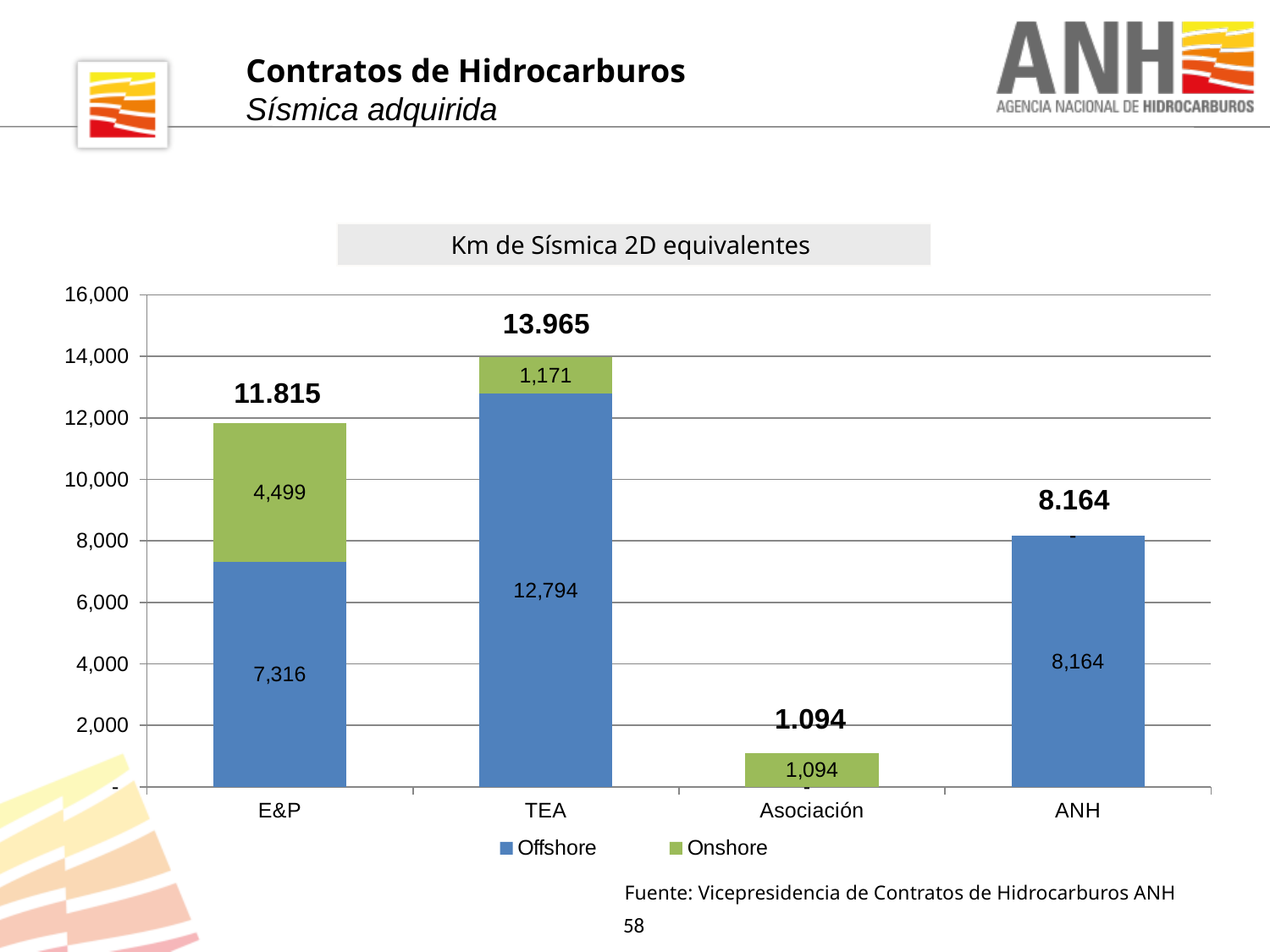
What is the Onshore value for E&P? 4,499 How many categories are shown on the x axis? 4 Which category has the lowest total? Asociación What is the total shown above the E&P bar? 11.815 How many series does the legend list? 2 Which category has the highest total? TEA What is the Offshore value for TEA? 12,794 Which is larger, the Onshore value for E&P or the Onshore value for TEA? E&P What is the total shown above the TEA bar? 13.965 What is the Onshore value for Asociación? 1,094 What is the Offshore value for ANH? 8,164 What is the difference between the Offshore values for TEA and E&P? 5,478